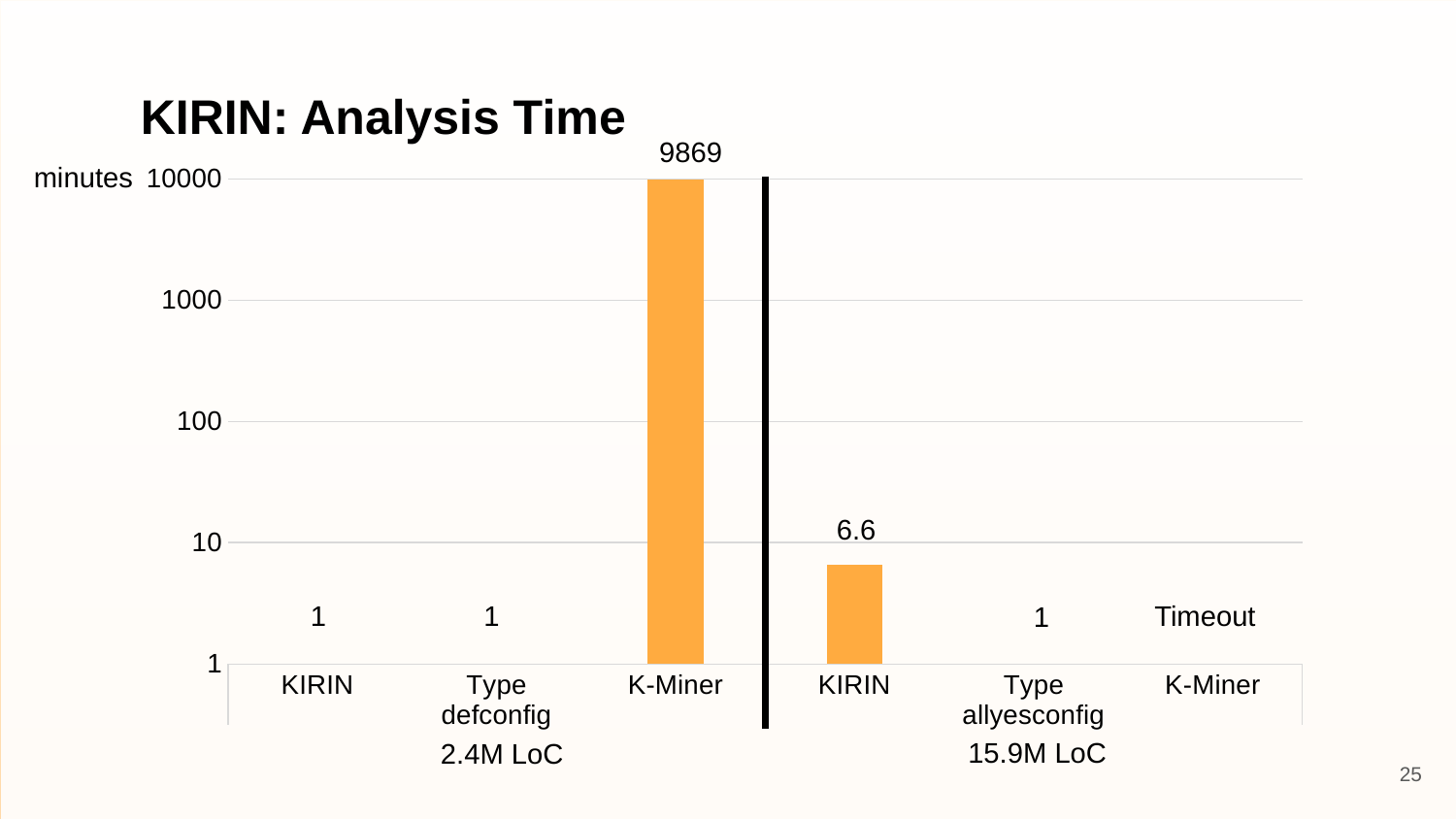
Which tool has the highest analysis time on defconfig? K-Miner What kind of chart is shown on the slide? bar chart What is the analysis time for KIRIN on allyesconfig? 6.6 What unit is the y axis measured in? minutes How many lines of code does the allyesconfig configuration have according to the chart? 15.9M LoC Is the analysis time for KIRIN on allyesconfig greater or less than 10? less What is shown for K-Miner on allyesconfig? Timeout What is the analysis time for KIRIN on defconfig? 1 What is the analysis time for K-Miner on defconfig? 9869 What is the difference between the analysis time of K-Miner and KIRIN on defconfig? 9868 Which is larger, the analysis time for KIRIN on defconfig or KIRIN on allyesconfig? KIRIN on allyesconfig Is the analysis time for K-Miner on defconfig greater or less than 1000? greater